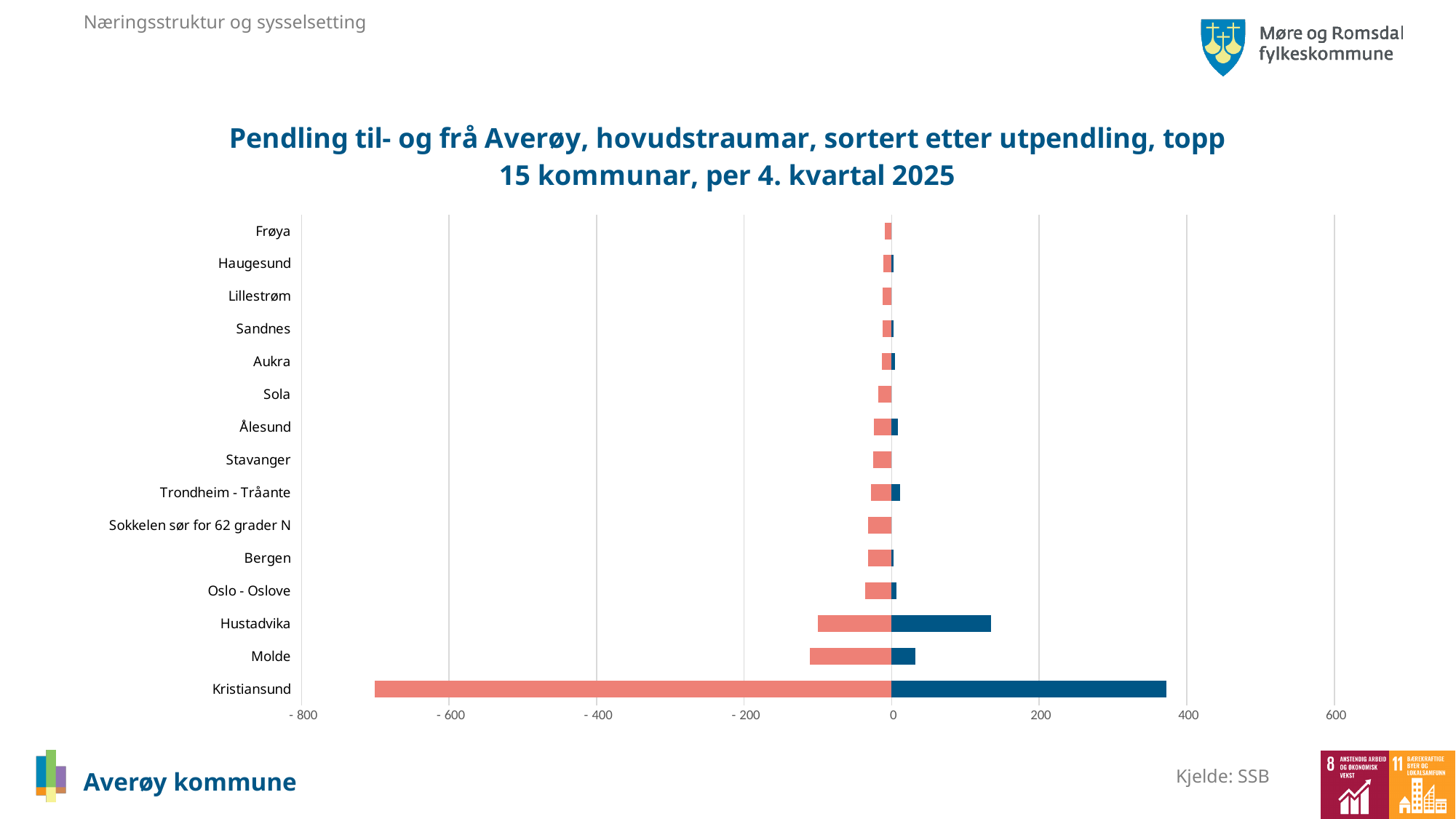
Is the red bar value for Hustadvika greater or less than -200? greater Which has the longer red bar, Kristiansund or Molde? Kristiansund Which municipality has the longest red bar (most negative value)? Kristiansund Which municipality has the longest blue bar (largest positive value)? Kristiansund What kind of chart is shown on the slide? bar chart How many municipalities (categories) are listed on the chart? 15 Is the blue bar value for Hustadvika greater or less than 200? less Which municipality is listed at the top of the chart? Frøya Is the blue bar value for Kristiansund greater or less than 200? greater What is the title of the chart? Pendling til- og frå Averøy, hovudstraumar, sortert etter utpendling, topp 15 kommunar, per 4. kvartal 2025 Which has the larger blue bar, Hustadvika or Molde? Hustadvika